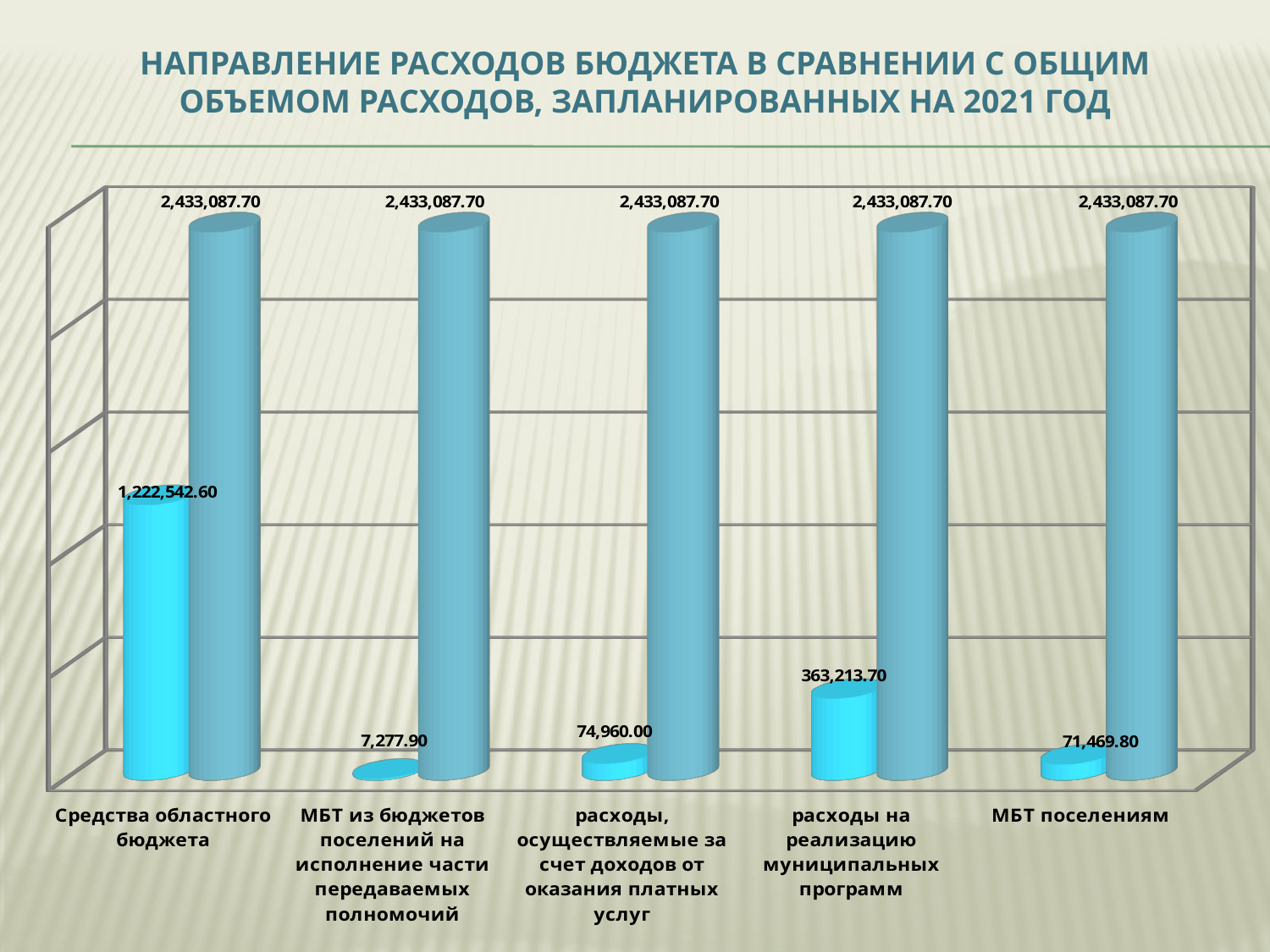
Which category has the lowest value among the smaller (light blue) bars? МБТ из бюджетов поселений на исполнение части передаваемых полномочий What is the difference between the total planned expenditure (2,433,087.70) and the value for "Средства областного бюджета"? 1,210,545.10 What is the value of the smaller bar for "МБТ поселениям"? 71,469.80 Which category has the highest value among the smaller (light blue) bars? Средства областного бюджета How many categories are shown on the x axis of the chart? 5 What is the difference between the smaller-bar values for "расходы на реализацию муниципальных программ" and "расходы, осуществляемые за счет доходов от оказания платных услуг"? 288,253.70 What value is shown on the taller (dark blue) bar in every category? 2,433,087.70 Which is larger: the smaller-bar value for "расходы на реализацию муниципальных программ" or for "МБТ поселениям"? расходы на реализацию муниципальных программ What is the value of the smaller bar for "расходы, осуществляемые за счет доходов от оказания платных услуг"? 74,960.00 What is the value of the smaller (light blue) bar for "Средства областного бюджета"? 1,222,542.60 What is the value of the smaller bar for "МБТ из бюджетов поселений на исполнение части передаваемых полномочий"? 7,277.90 What is the value of the smaller bar for "расходы на реализацию муниципальных программ"? 363,213.70